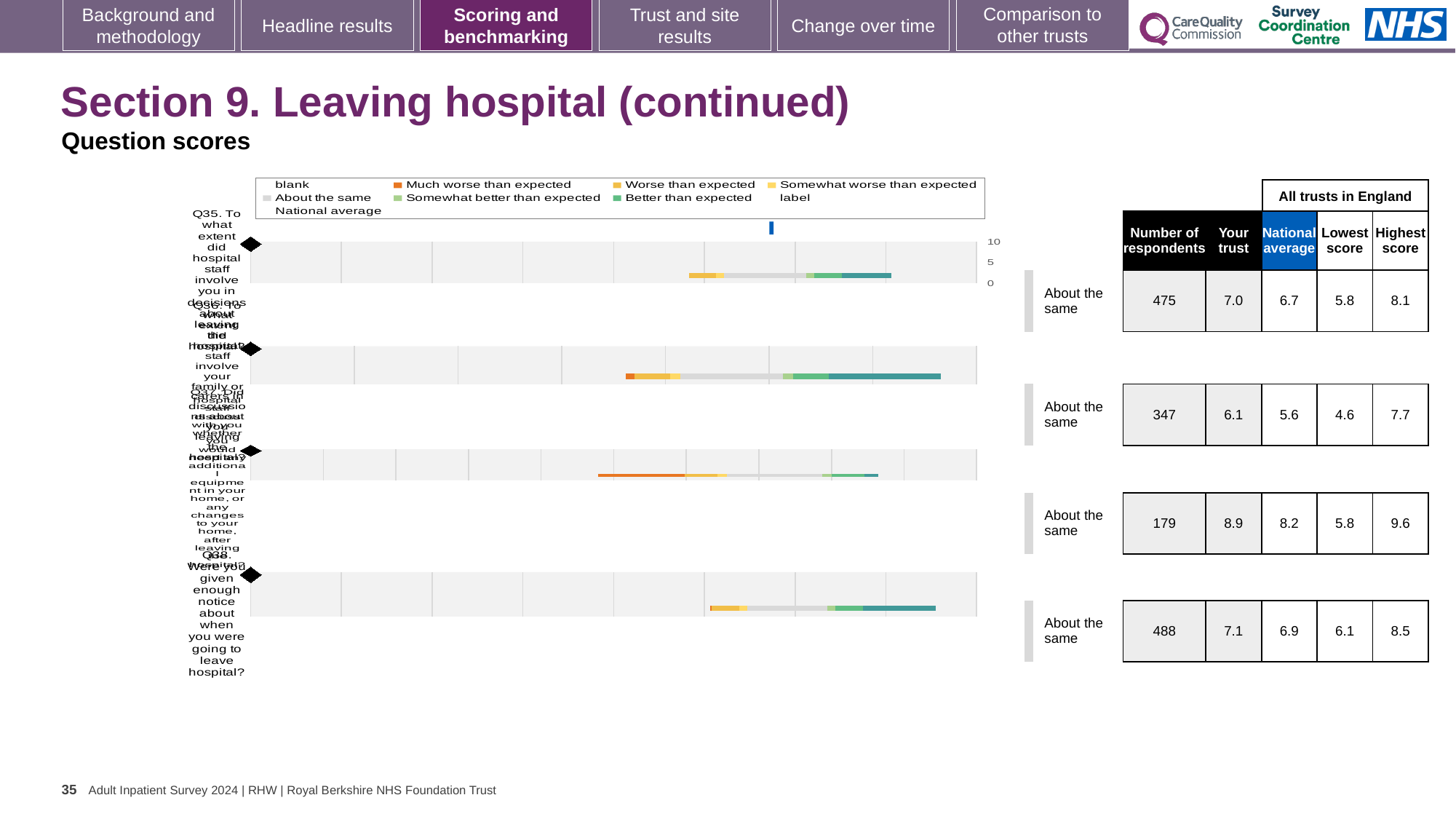
In the table beside the charts, what is the 'Your trust' score for the first row (Q35)? 7.0 How many separate bar charts are shown on the slide? 4 In the table beside the charts, what is the difference between the 'Your trust' score and the 'National average' in the third row? 0.7 In the table beside the charts, is the 'Your trust' score for the second row larger or smaller than its 'National average'? larger In the table beside the charts, which row has the lowest 'Number of respondents'? the third row (179) What kind of charts are shown on the slide? bar charts In the table beside the charts, what is the 'Highest score' for the first row (Q35)? 8.1 What benchmark category label is shown to the right of each of the four bar charts? About the same What is the maximum value shown on the x axis of the top bar chart? 10 In the table beside the charts, what is the 'Number of respondents' for the last row (Q38)? 488 In the table beside the charts, which row has the highest 'Your trust' score? the third row (8.9) In the table beside the charts, what is the 'National average' for the last row (Q38)? 6.9